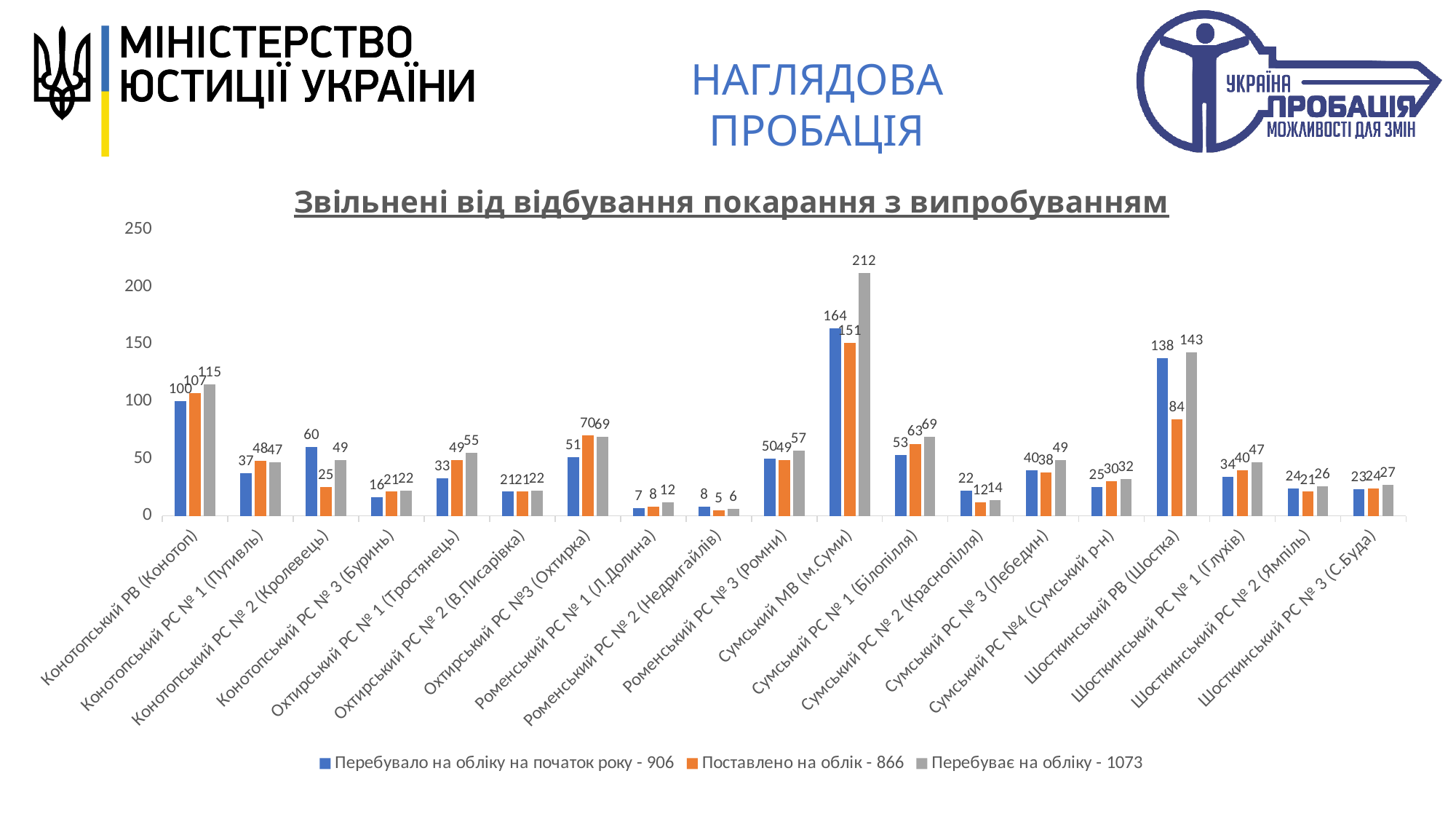
Is the value of "Перебуває на обліку - 1073" for Шосткинський РВ (Шостка) greater or less than 100? greater How many categories are shown on the x axis? 19 Which category has the highest value for "Перебуває на обліку - 1073"? Сумський МВ (м.Суми) How many series does the legend list? 3 Which category has the lowest value for "Поставлено на облік - 866"? Роменський РС № 2 (Недригайлів) For Конотопський РС № 2 (Кролевець), which is larger: "Перебувало на обліку на початок року - 906" or "Поставлено на облік - 866"? Перебувало на обліку на початок року - 906 What is the value of "Перебувало на обліку на початок року - 906" for Конотопський РС № 2 (Кролевець)? 60 What is the difference between "Перебуває на обліку - 1073" and "Перебувало на обліку на початок року - 906" for Сумський МВ (м.Суми)? 48 What is the value of "Перебуває на обліку - 1073" for Сумський МВ (м.Суми)? 212 What type of chart is shown on the slide? bar chart What is the value of "Поставлено на облік - 866" for Шосткинський РВ (Шостка)? 84 What is the title of the chart? Звільнені від відбування покарання з випробуванням